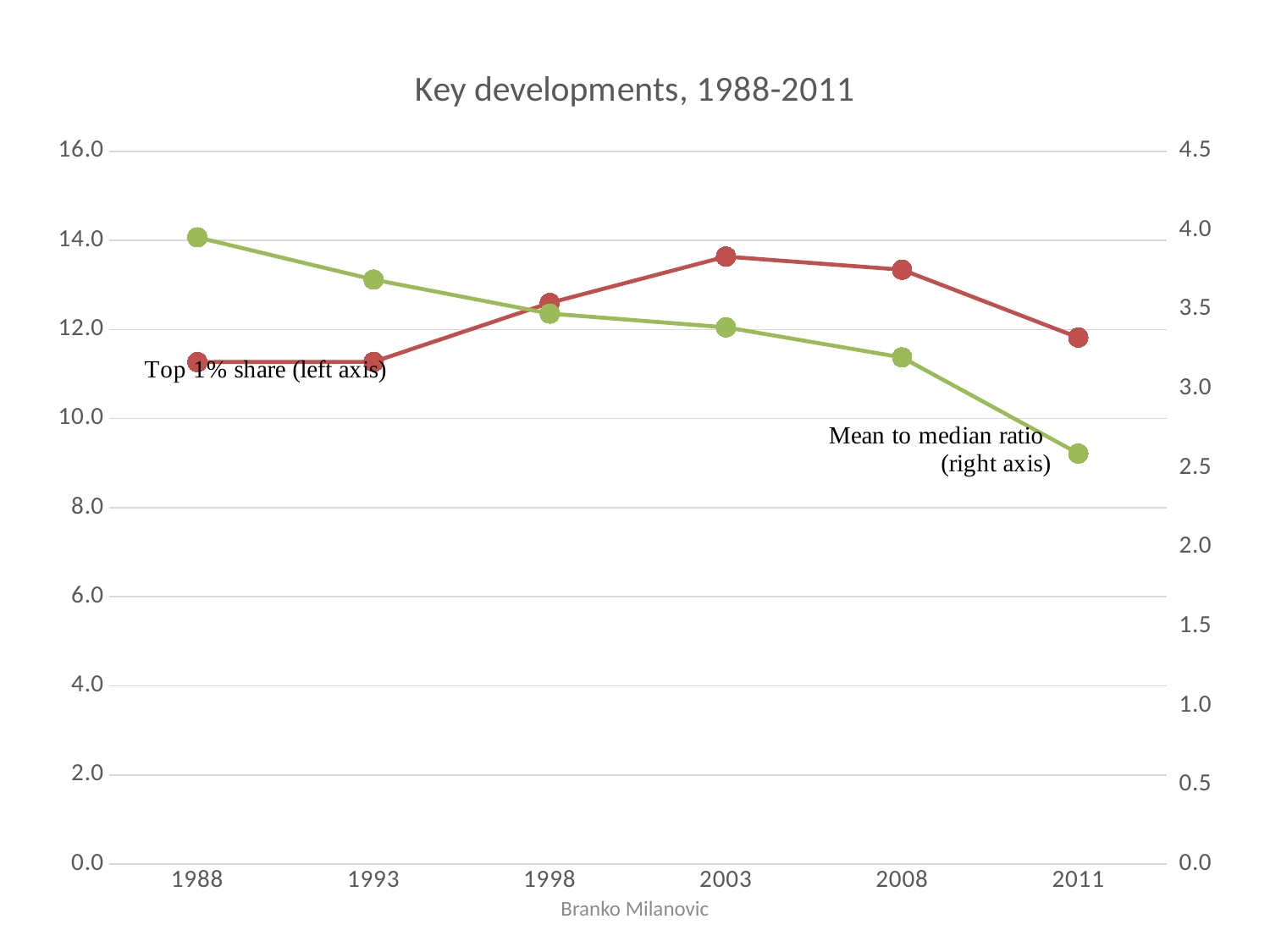
What is the title of the chart? Key developments, 1988-2011 Does the Top 1% share rise or fall between 1993 and 2003? rise In which year is the Mean to median ratio lowest? 2011 Which series is plotted against the right axis? Mean to median ratio Is the Mean to median ratio in 2011 greater or less than 3.0? less Does the Mean to median ratio rise or fall from 1988 to 2011? fall How many years are plotted along the x axis? 6 Which is larger, the Top 1% share in 2003 or in 2011? 2003 Is the Top 1% share in 2003 greater or less than 12.0? greater In which year is the Mean to median ratio highest? 1988 In which year is the Top 1% share highest? 2003 What kind of chart is shown on the slide? line chart